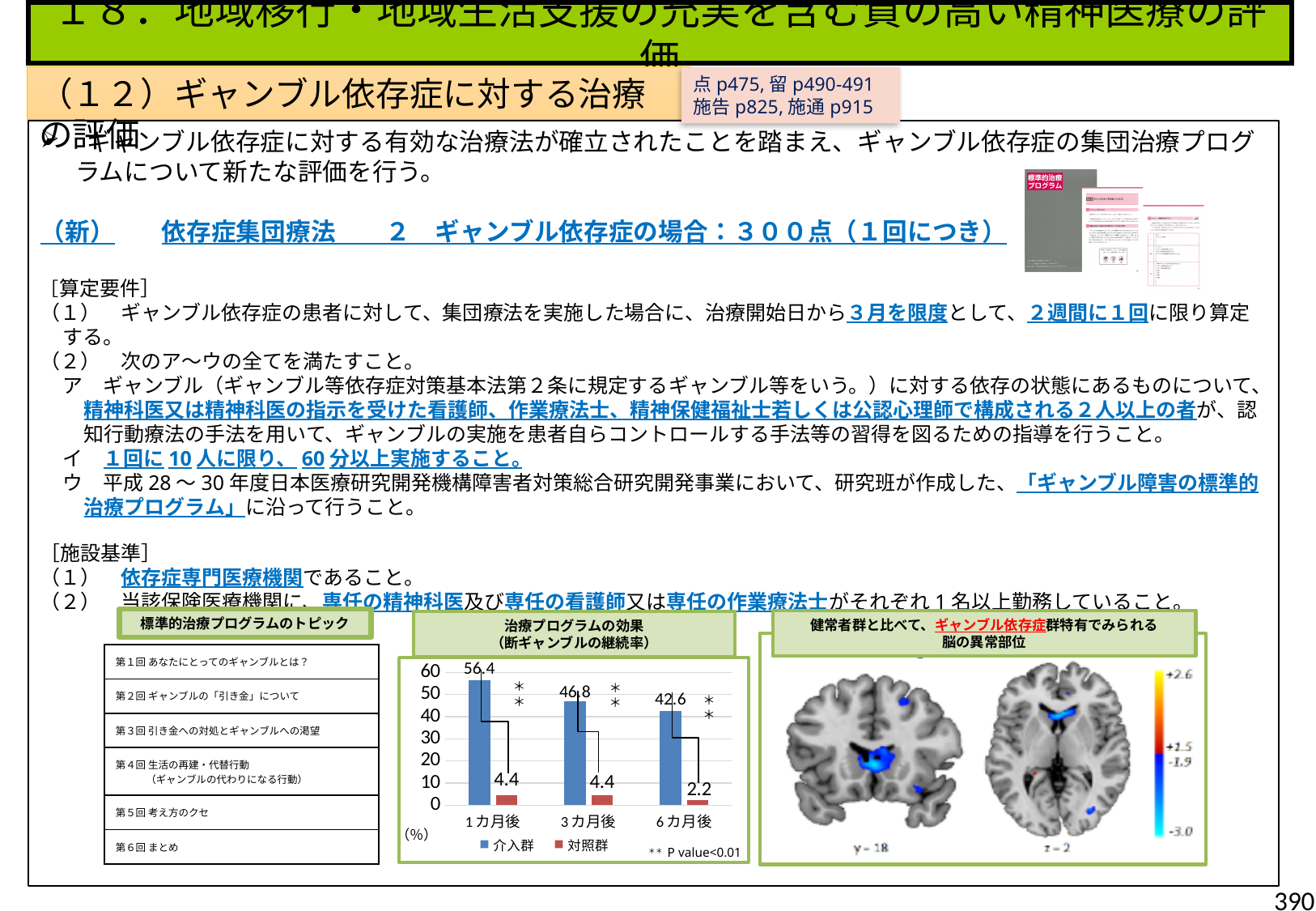
What is the value for 対照群 at 3カ月後 in the 治療プログラムの効果 chart? 4.4 What is the value for 対照群 at 6カ月後 in the 治療プログラムの効果 chart? 2.2 In the 治療プログラムの効果 chart, what is the difference between 介入群 and 対照群 at 6カ月後? 40.4 What is the value for 介入群 at 1カ月後 in the 治療プログラムの効果 chart? 56.4 What is the value for 介入群 at 3カ月後 in the 治療プログラムの効果 chart? 46.8 In the 治療プログラムの効果 chart, do the 介入群 values rise or fall from 1カ月後 to 6カ月後? fall What kind of chart is the 治療プログラムの効果 chart? bar chart In the 治療プログラムの効果 chart, which is larger at 1カ月後: 介入群 or 対照群? 介入群 In the 治療プログラムの効果 chart, at which time point is the 介入群 value highest? 1カ月後 How many time-point categories are shown on the x axis of the 治療プログラムの効果 chart? 3 In the 治療プログラムの効果 chart, at which time point is the 対照群 value lowest? 6カ月後 How many series does the legend of the 治療プログラムの効果 chart list? 2